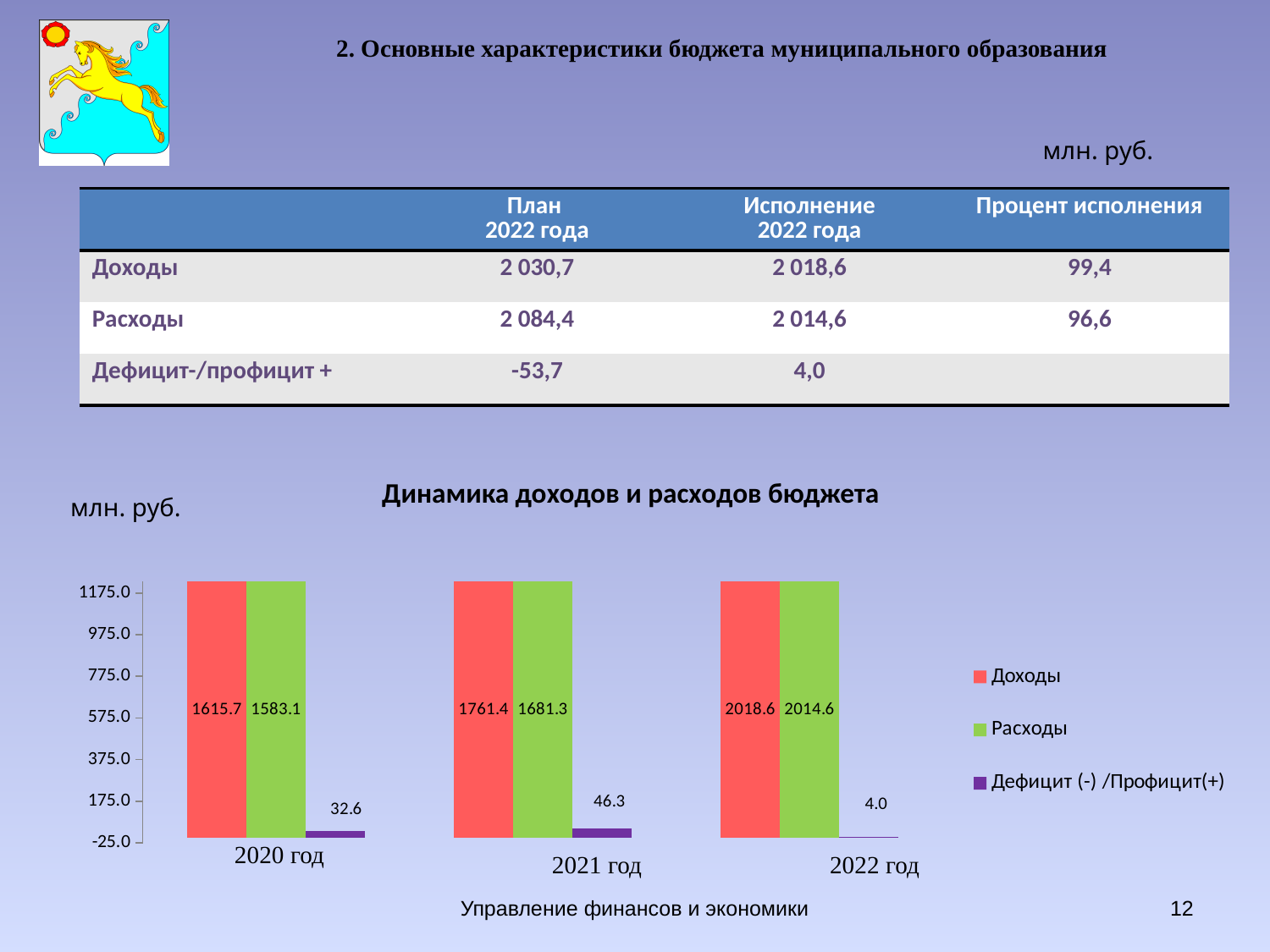
In the chart "Динамика доходов и расходов бюджета", what colour are the Расходы bars? green In the chart "Динамика доходов и расходов бюджета", what is the difference between Доходы and Расходы for 2021 год? 80.1 How many years are shown on the x axis of the chart "Динамика доходов и расходов бюджета"? 3 What type of chart is "Динамика доходов и расходов бюджета"? bar chart In the chart "Динамика доходов и расходов бюджета", which is larger for 2020 год: Доходы or Расходы? Доходы In the chart "Динамика доходов и расходов бюджета", what is the value of Дефицит (-) /Профицит(+) for 2021 год? 46.3 In the chart "Динамика доходов и расходов бюджета", which year has the lowest value of Дефицит (-) /Профицит(+)? 2022 год In the chart "Динамика доходов и расходов бюджета", what is the value of Расходы for 2020 год? 1583.1 In the chart "Динамика доходов и расходов бюджета", what is the value of Доходы for 2022 год? 2018.6 How many series does the legend of the chart "Динамика доходов и расходов бюджета" list? 3 In the chart "Динамика доходов и расходов бюджета", do the values of Расходы rise or fall from 2020 год to 2022 год? rise In the chart "Динамика доходов и расходов бюджета", which year has the highest value of Доходы? 2022 год